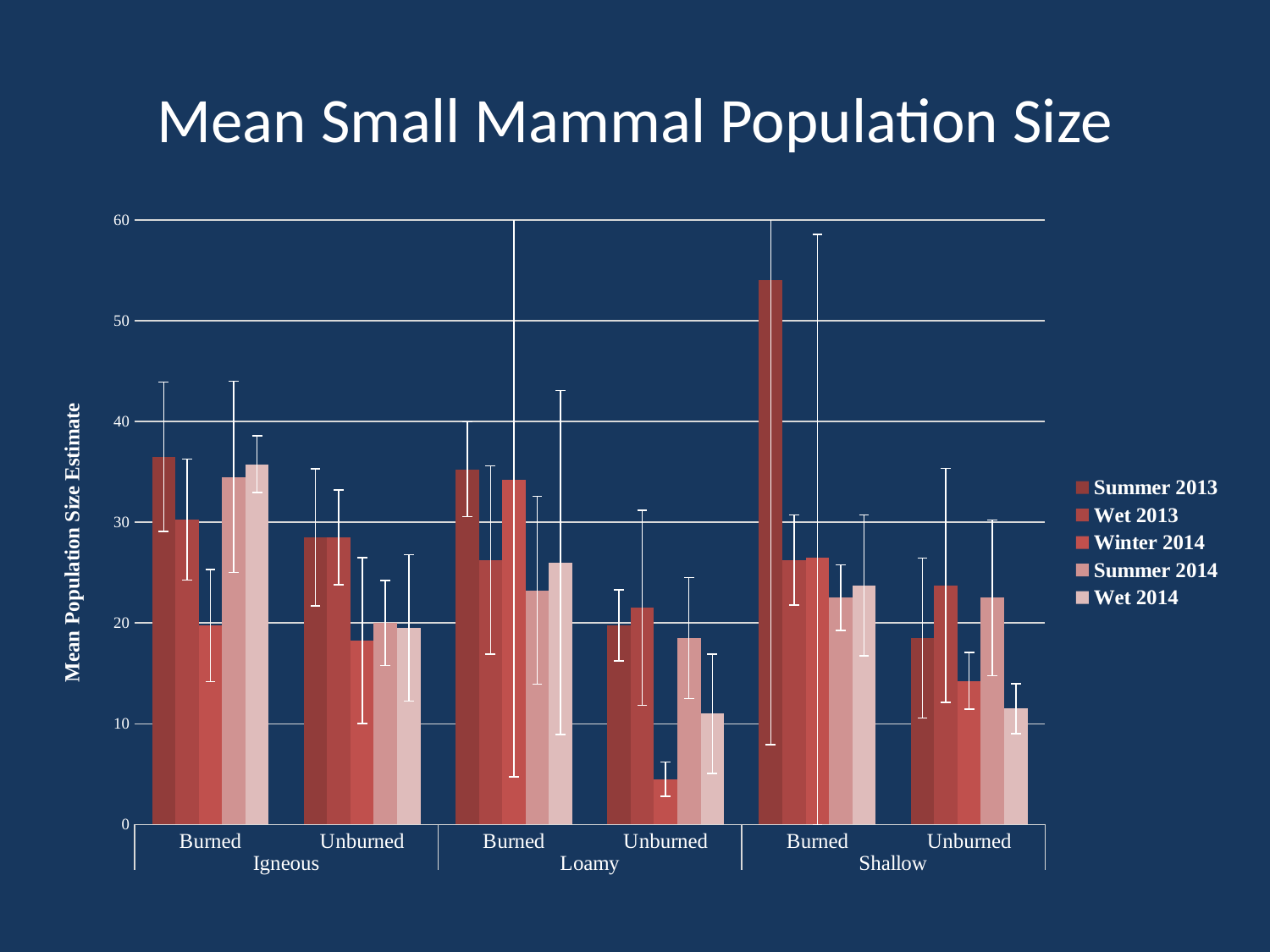
Is the Summer 2013 value for Igneous Burned greater or less than 30? greater Is the Summer 2013 value for Shallow Burned greater or less than 50? greater Is the Wet 2014 value for Loamy Unburned greater or less than 20? less What kind of chart is shown on the slide? Bar chart How many Burned/Unburned category groups are shown along the x axis? 6 Which series has the tallest bar in the whole chart, and in which group? Summer 2013, Shallow Burned In the Igneous Burned group, which is larger: the Summer 2013 value or the Winter 2014 value? Summer 2013 Which series has the shortest bar in the whole chart, and in which group? Winter 2014, Loamy Unburned What is the title of the y axis? Mean Population Size Estimate How many series does the legend list? 5 In the Loamy Unburned group, which is larger: the Summer 2014 value or the Wet 2014 value? Summer 2014